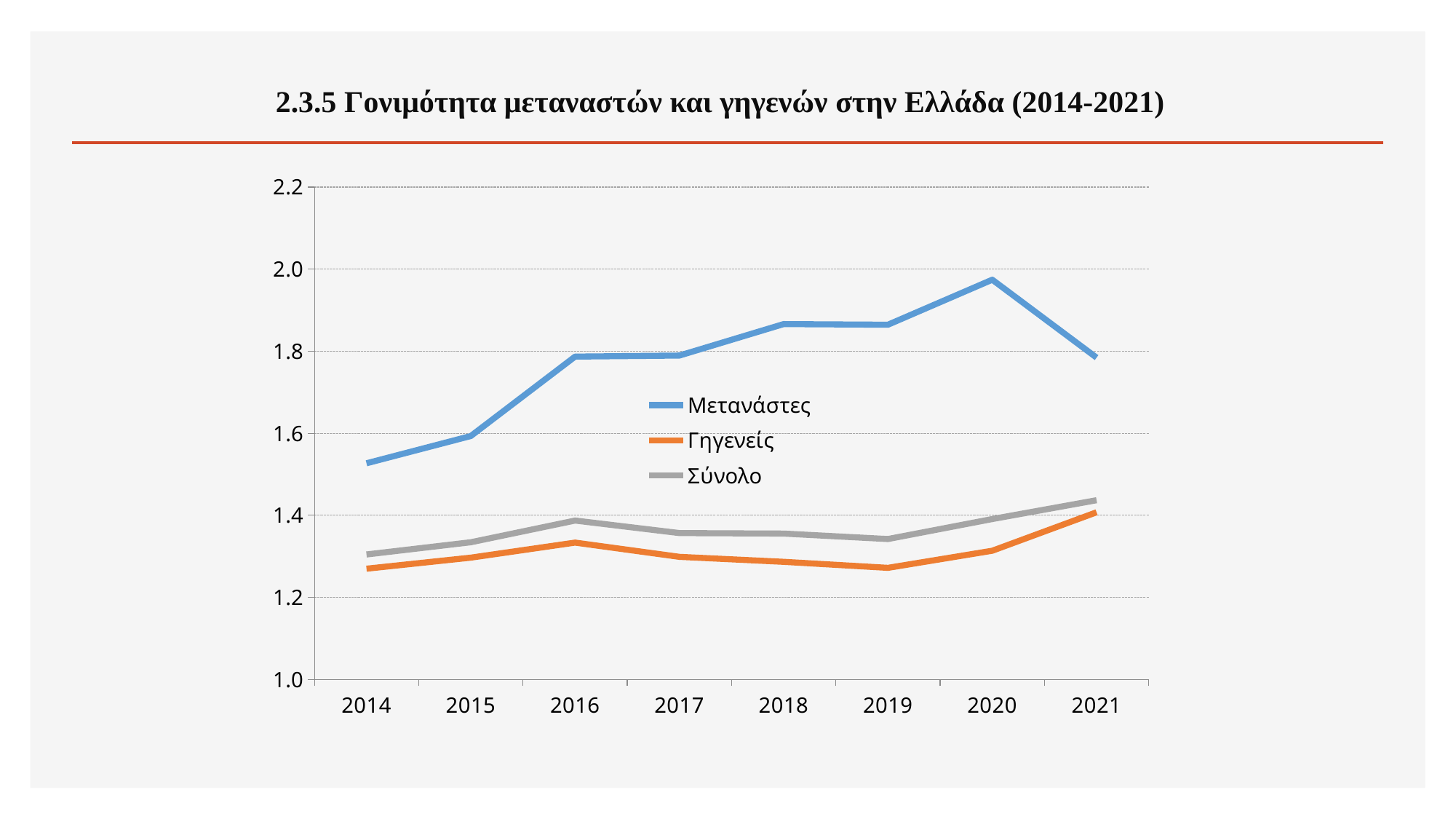
Is the value for Μετανάστες in 2020 greater or less than 1.8? greater In which year does the Μετανάστες series have its lowest value? 2014 Is the value for Γηγενείς in 2014 greater or less than 1.4? less What kind of chart is shown on the slide? line chart In which year does the Σύνολο series reach its highest value? 2021 In which year does the Μετανάστες series reach its highest value? 2020 Does the Μετανάστες series rise or fall from 2020 to 2021? fall In which year does the Γηγενείς series reach its highest value? 2021 Which series has the higher value in 2018, Μετανάστες or Γηγενείς? Μετανάστες How many series does the legend list? 3 How many years are shown on the x axis? 8 Is the value for Μετανάστες in 2014 greater or less than 1.6? less